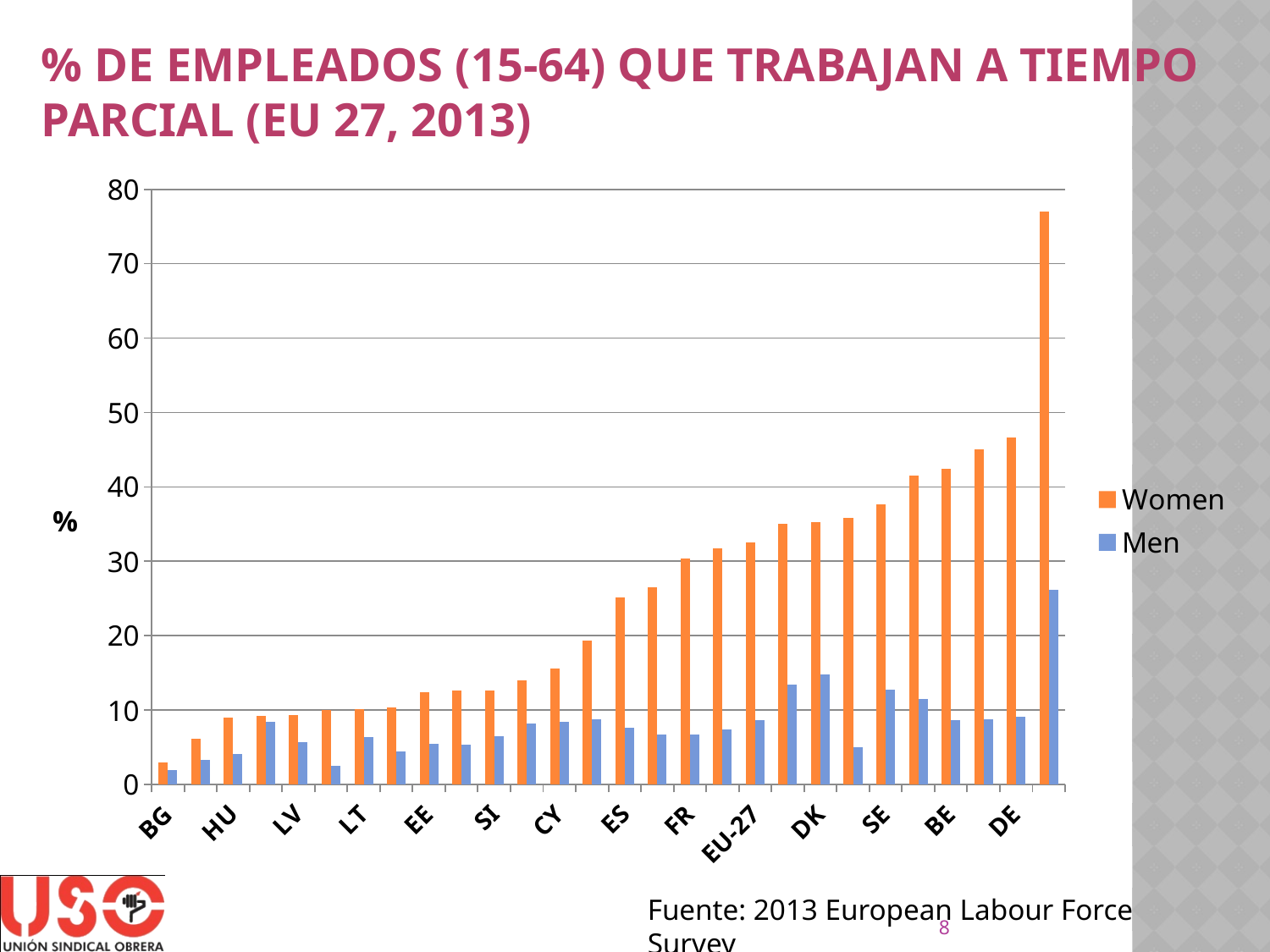
Is the Men value for DK greater or less than 10? greater What kind of chart is shown on the slide? bar chart Which two series are shown in the legend? Women and Men Is the Women value for DE greater or less than 40? greater Which colour represents Women in the chart? orange Do the Women values rise or fall moving from left to right along the x axis? rise For DE, which is larger, the Women value or the Men value? Women Which labelled country has the lowest Women value? BG Is the Women value for SE greater or less than 30? greater How many series does the legend list? 2